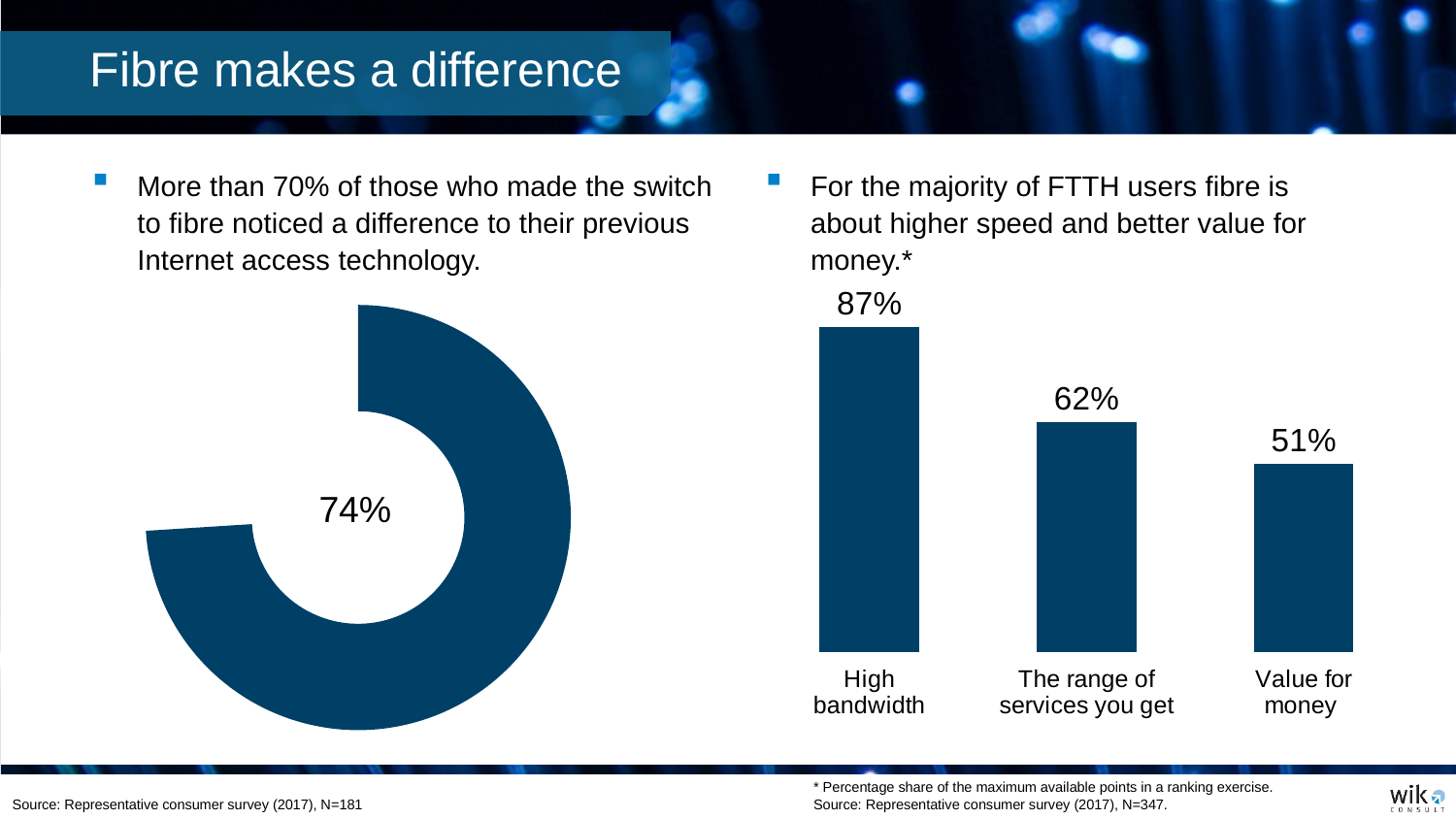
On the bar chart on the right, which is larger: The range of services you get or Value for money? The range of services you get How many categories does the bar chart on the right show? 3 On the bar chart on the right, what is the difference between High bandwidth and The range of services you get? 25% On the bar chart on the right, what is the value for High bandwidth? 87% On the bar chart on the right, which category has the highest value? High bandwidth What kind of chart is on the right side of the slide? Bar chart What percentage is shown on the doughnut chart on the left? 74% What kind of chart is on the left side of the slide? Doughnut chart On the bar chart on the right, what is the value for The range of services you get? 62% On the bar chart on the right, what is the difference between High bandwidth and Value for money? 36% On the bar chart on the right, which category has the lowest value? Value for money On the bar chart on the right, what is the value for Value for money? 51%